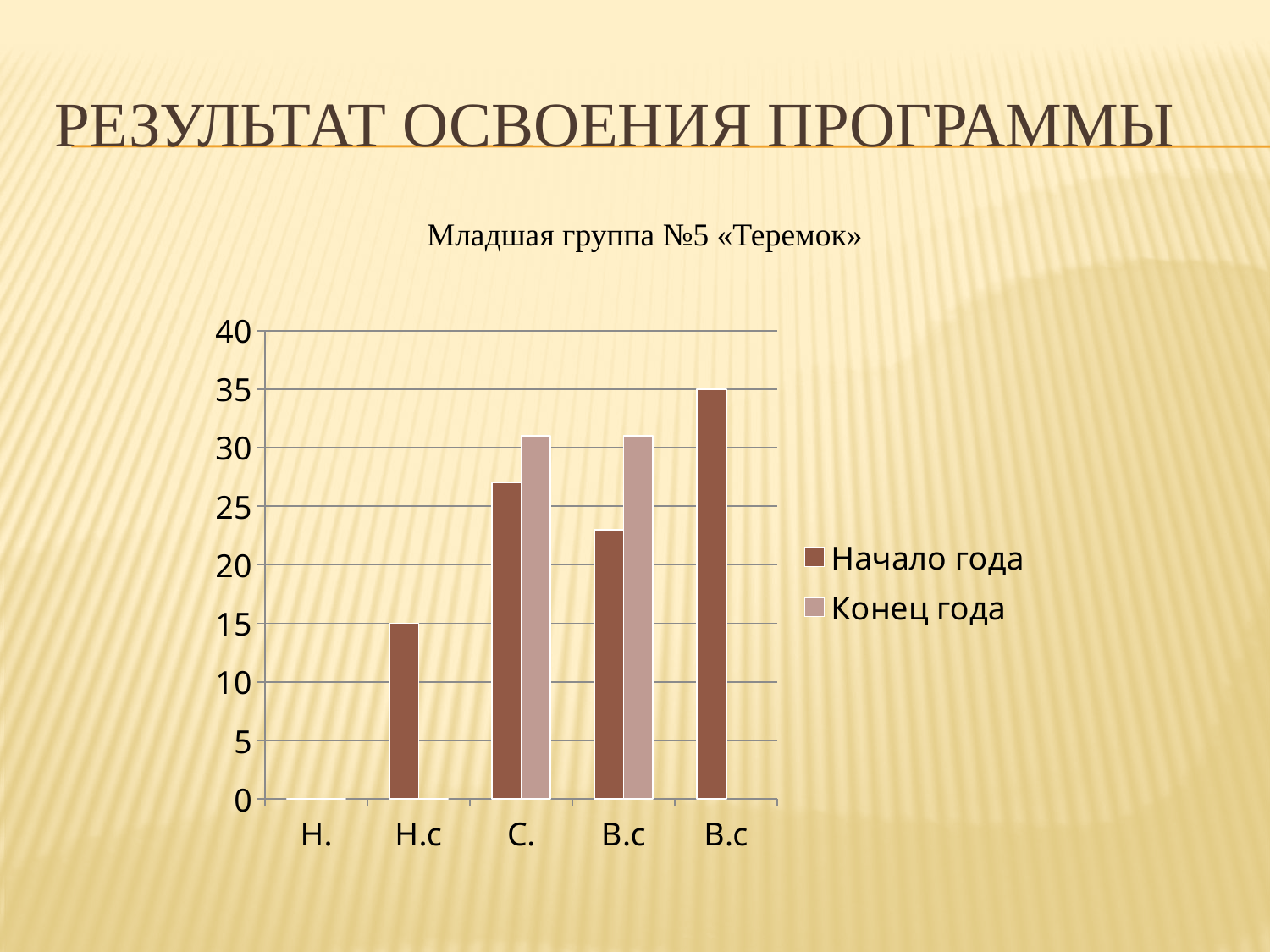
What is the value of Начало года for the category Н.с? 15 How many categories are shown on the x axis? 5 What is the title of the chart? Младшая группа №5 «Теремок» For the category С., which is larger: Начало года or Конец года? Конец года Is the Начало года value for С. greater or less than 25? greater Is the Начало года value for the fourth category (В.с) greater or less than 25? less Which category has the highest Начало года bar? the rightmost В.с What kind of chart is shown on the slide? bar chart Is the Конец года value for С. greater or less than 30? greater How many series does the legend list? 2 What are the two entries in the legend? Начало года, Конец года What is the value of Начало года for the rightmost category (В.с)? 35